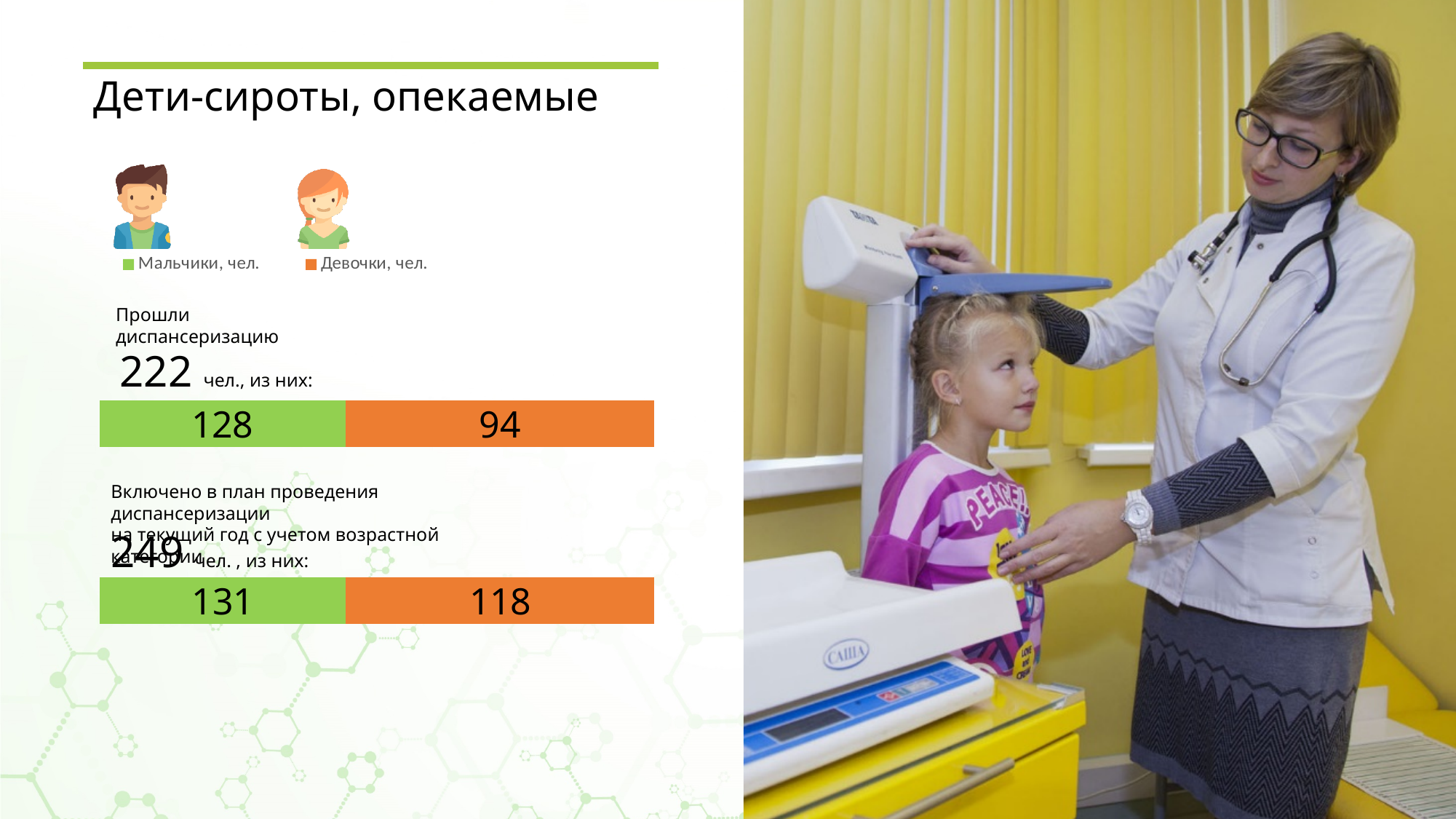
How many series does the legend list? 2 In the top bar (Прошли диспансеризацию), which is larger, Мальчики or Девочки? Мальчики In the top bar (Прошли диспансеризацию), what is the total of the stacked bar? 222 In the bottom bar (Включено в план проведения диспансеризации), what is the total of the stacked bar? 249 In the top bar (Прошли диспансеризацию), what is the value for Мальчики? 128 In the bottom bar (Включено в план проведения диспансеризации), what is the difference between the values for Мальчики and Девочки? 13 In the top bar (Прошли диспансеризацию), what is the difference between the values for Мальчики and Девочки? 34 In the top bar (Прошли диспансеризацию), what is the value for Девочки? 94 Which colour represents Девочки, чел. in the legend? Orange In the bottom bar (Включено в план проведения диспансеризации), what is the value for Девочки? 118 In the bottom bar (Включено в план проведения диспансеризации), what is the value for Мальчики? 131 What kind of chart is used on the slide? Stacked bar chart